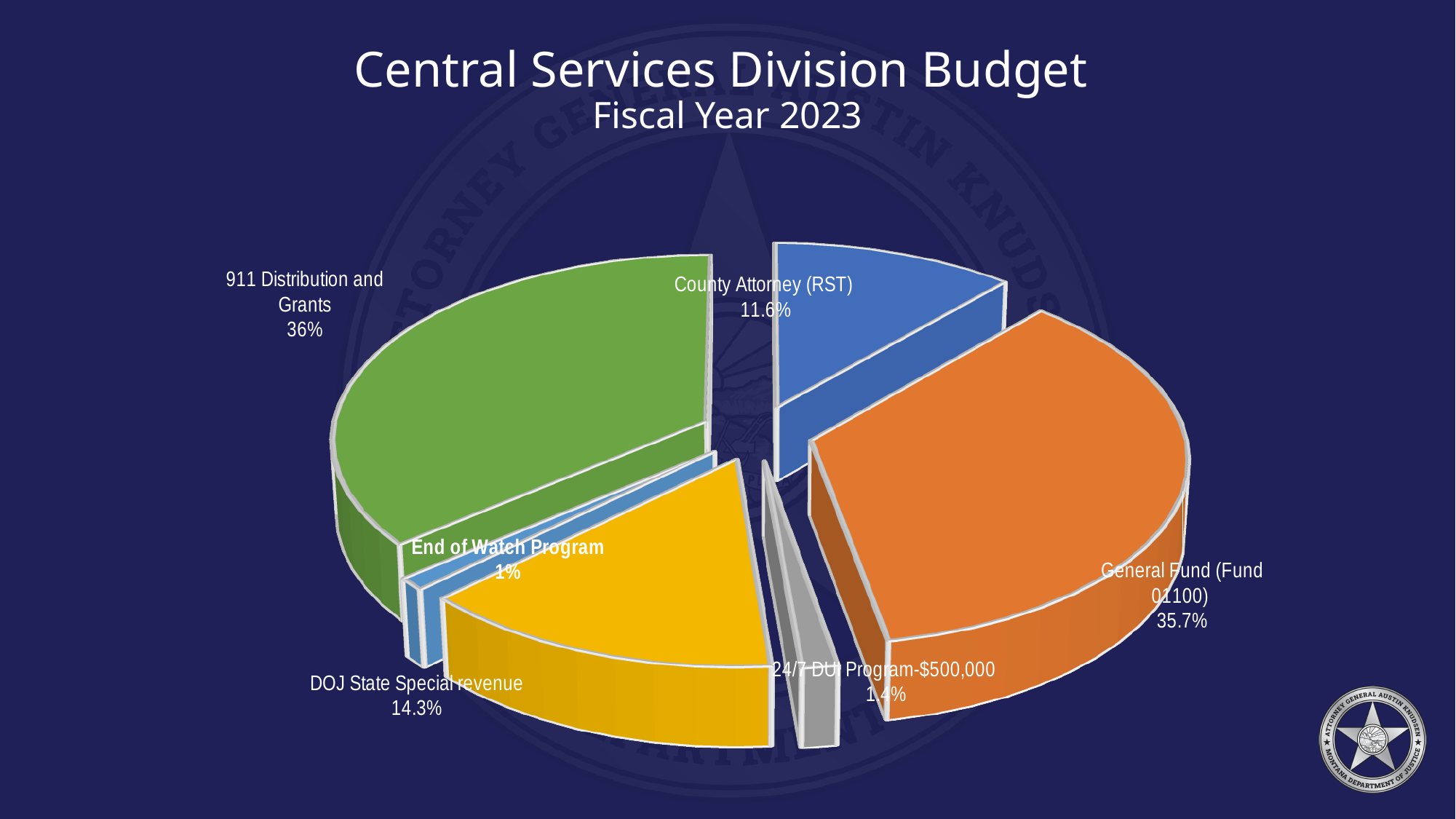
What percentage is shown for the End of Watch Program? 1% What percentage is shown for DOJ State Special revenue? 14.3% What kind of chart is shown on the slide? Pie chart What percentage is shown for General Fund (Fund 01100)? 35.7% What is the difference in percentage points between DOJ State Special revenue and County Attorney (RST)? 2.7 What percentage is shown for County Attorney (RST)? 11.6% What share of the budget goes to 911 Distribution and Grants? 36% How many slices does the pie chart have? 6 Which is larger, the share for General Fund (Fund 01100) or the share for DOJ State Special revenue? General Fund (Fund 01100) Which category has the largest share of the pie? 911 Distribution and Grants Which category has the smallest share of the pie? End of Watch Program What fiscal year does the chart title refer to? Fiscal Year 2023